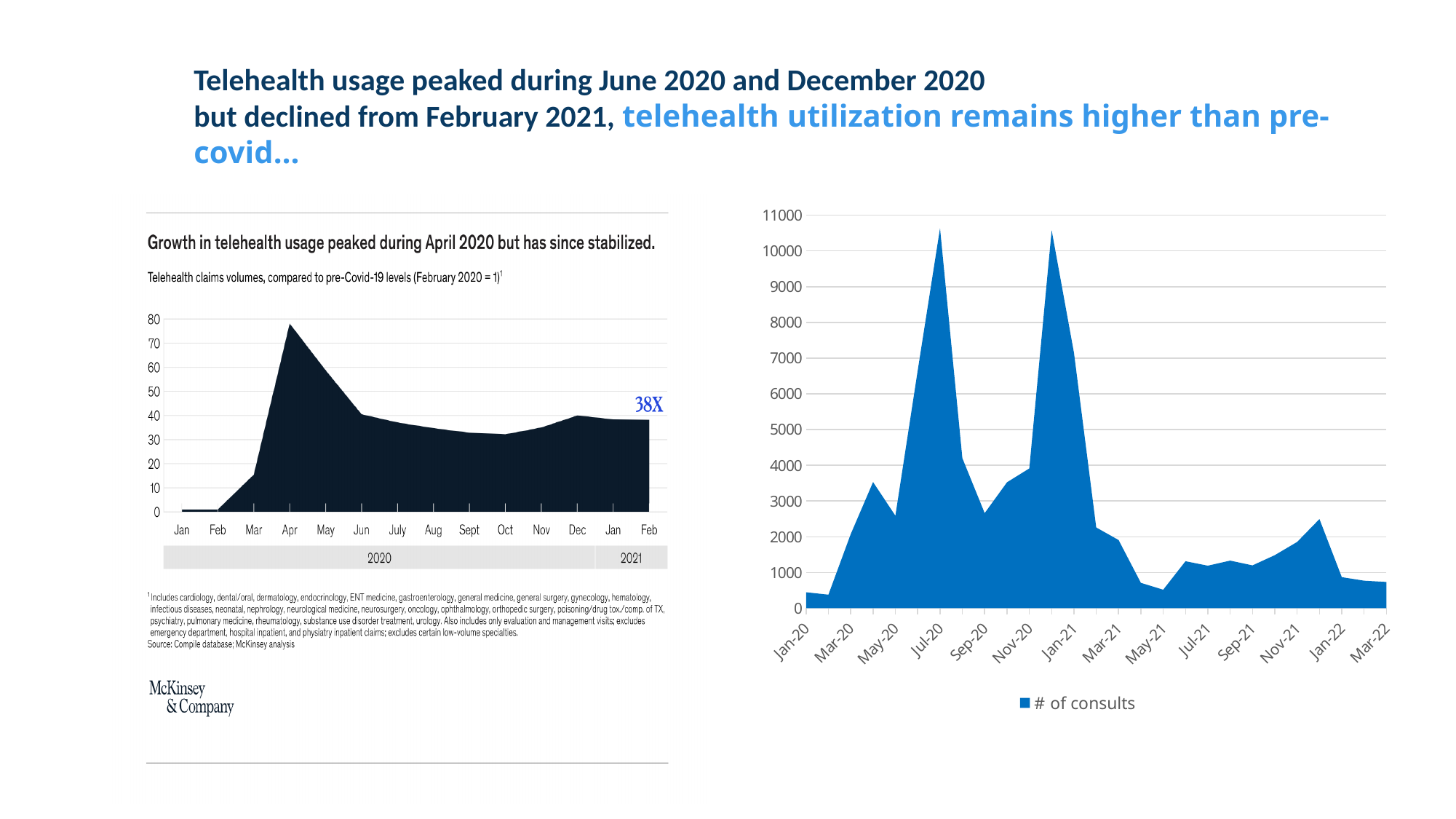
How many series does the legend of the right-hand chart list? 1 In the right-hand chart, is the value for Jul-20 greater or less than 10000? greater In the left-hand McKinsey chart, what value is labelled for Feb 2021? 38X In the left-hand McKinsey chart, which month has the highest value? Apr 2020 What kind of chart is the right-hand chart with the '# of consults' legend? area chart In the right-hand chart, which is larger, the value for Jul-20 or the value for Mar-22? Jul-20 In the right-hand chart, is the value for Jan-21 greater or less than 10000? less What is the legend entry of the right-hand chart? # of consults In the right-hand chart, is the value for Mar-22 greater or less than 1000? less In the left-hand McKinsey chart, do the values rise or fall from Apr 2020 to Oct 2020? fall